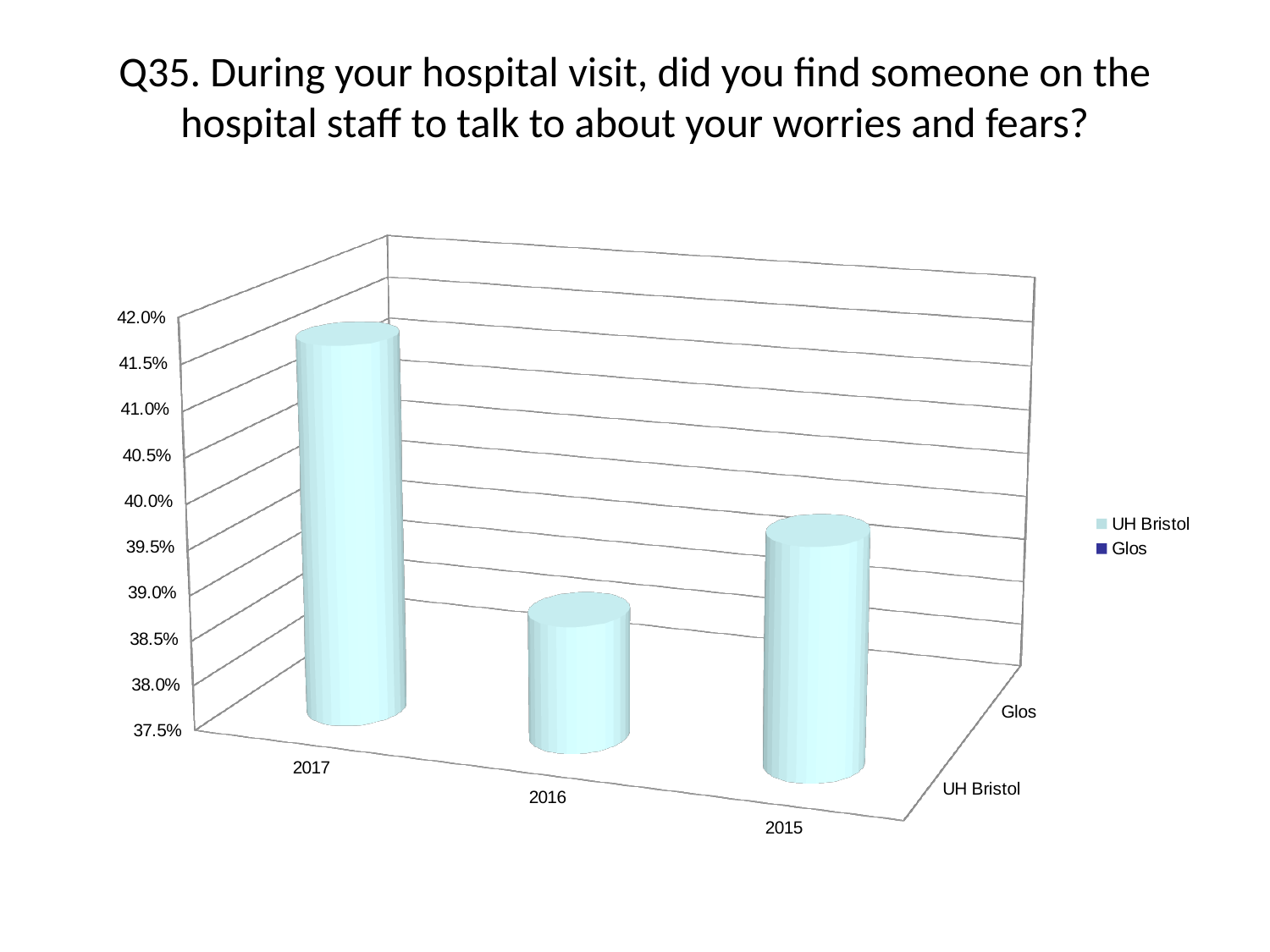
Is the UH Bristol value for 2016 larger or smaller than the value for 2015? smaller How many year categories are shown on the x axis of the chart? 3 Is the UH Bristol value for 2016 greater or less than 40.0%? less What kind of chart is shown on the slide? bar chart How many series does the chart's legend list? 2 Which year has the highest UH Bristol value in the chart? 2017 Does the UH Bristol value rise or fall from 2017 to 2016? fall Is the UH Bristol value for 2017 larger or smaller than the value for 2015? larger What are the two series named in the chart's legend? UH Bristol and Glos Is the UH Bristol value for 2017 greater or less than 40.0%? greater What is the lowest value shown on the chart's vertical axis? 37.5% Which year has the lowest UH Bristol value in the chart? 2016